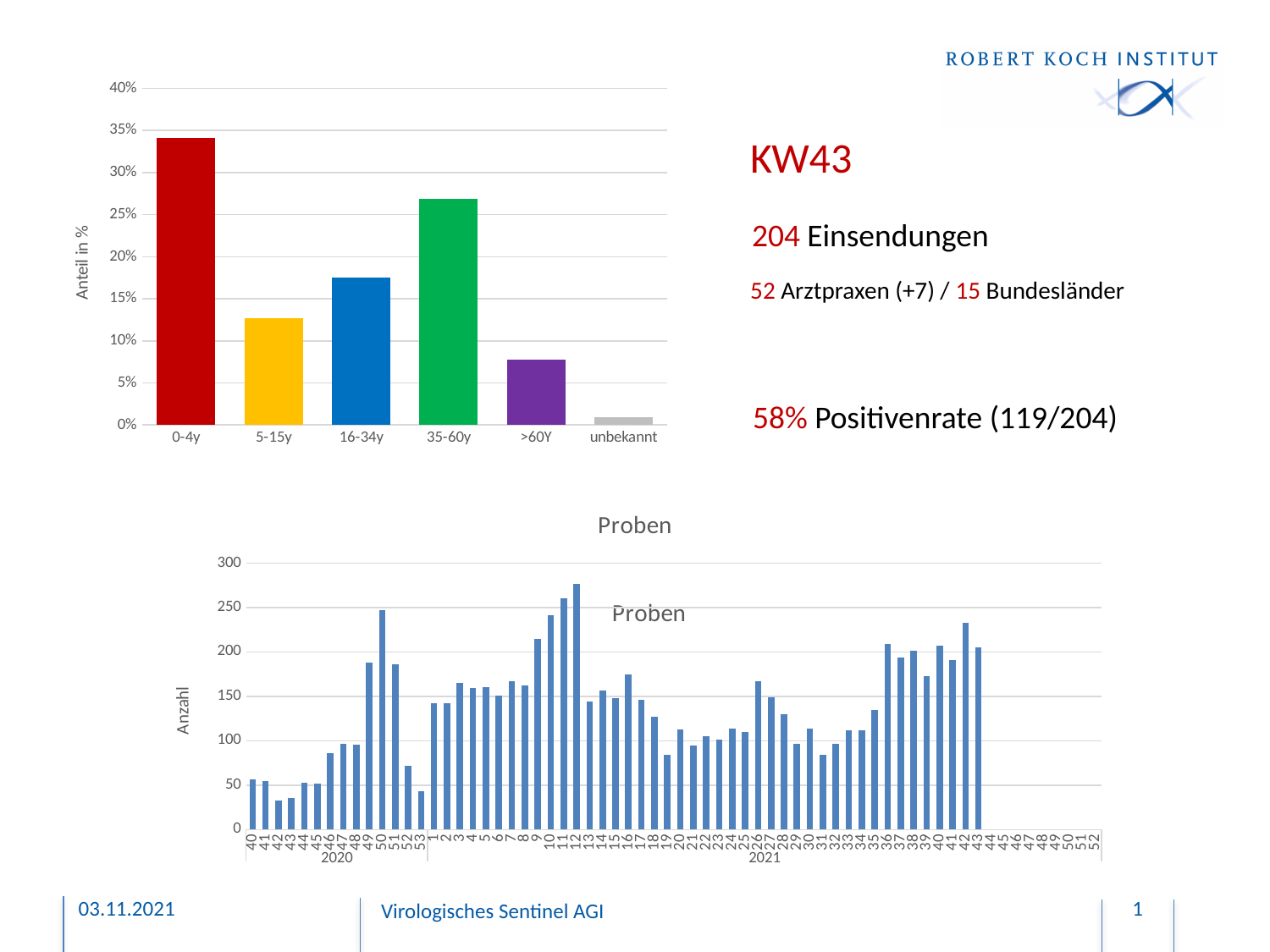
What kind of chart is the top-left chart (Anteil in %)? bar chart What is the title of the bottom chart? Proben In the top-left chart (Anteil in %), is the value for 0-4y greater or less than 30%? greater In the top-left chart (Anteil in %), is the value for 35-60y greater or less than 25%? greater How many age categories are shown on the x axis of the top-left chart (Anteil in %)? 6 In the top-left chart (Anteil in %), which age group has the highest share? 0-4y In the top-left chart (Anteil in %), which is larger, the share for 16-34y or the share for >60Y? 16-34y In the top-left chart (Anteil in %), which category has the lowest share? unbekannt In the top-left chart (Anteil in %), is the value for 5-15y greater or less than 15%? less What is the y-axis label of the bottom chart (Proben)? Anzahl In the bottom chart (Proben), in which week of 2021 is the number of samples highest? 12